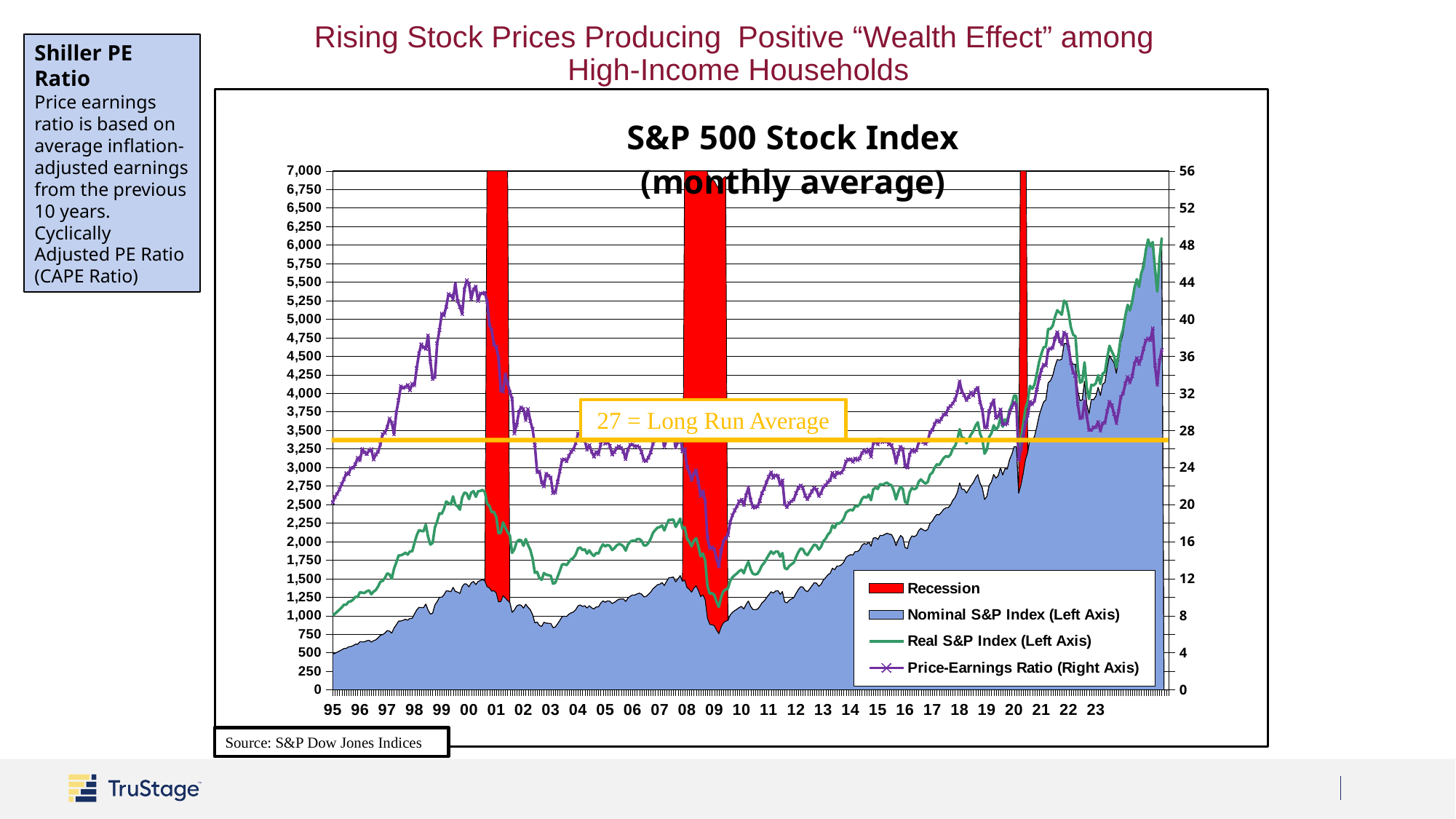
Does the Nominal S&P Index generally rise or fall from 95 to the end of the series? rise What value is labelled as the long run average on the chart? 27 Is the Nominal S&P Index value at the end of the series greater or less than 4,000? greater How many recession periods are shaded on the chart? 3 Is the peak of the Price-Earnings Ratio around 00 greater or less than 40? greater What is the title of the chart on the slide? S&P 500 Stock Index (monthly average) In 10, which is higher: the Real S&P Index or the Nominal S&P Index? Real S&P Index Is the Nominal S&P Index value in 95 greater or less than 1,000? less How many entries does the chart's legend list? 4 What kind of chart is shown on the slide? area and line chart